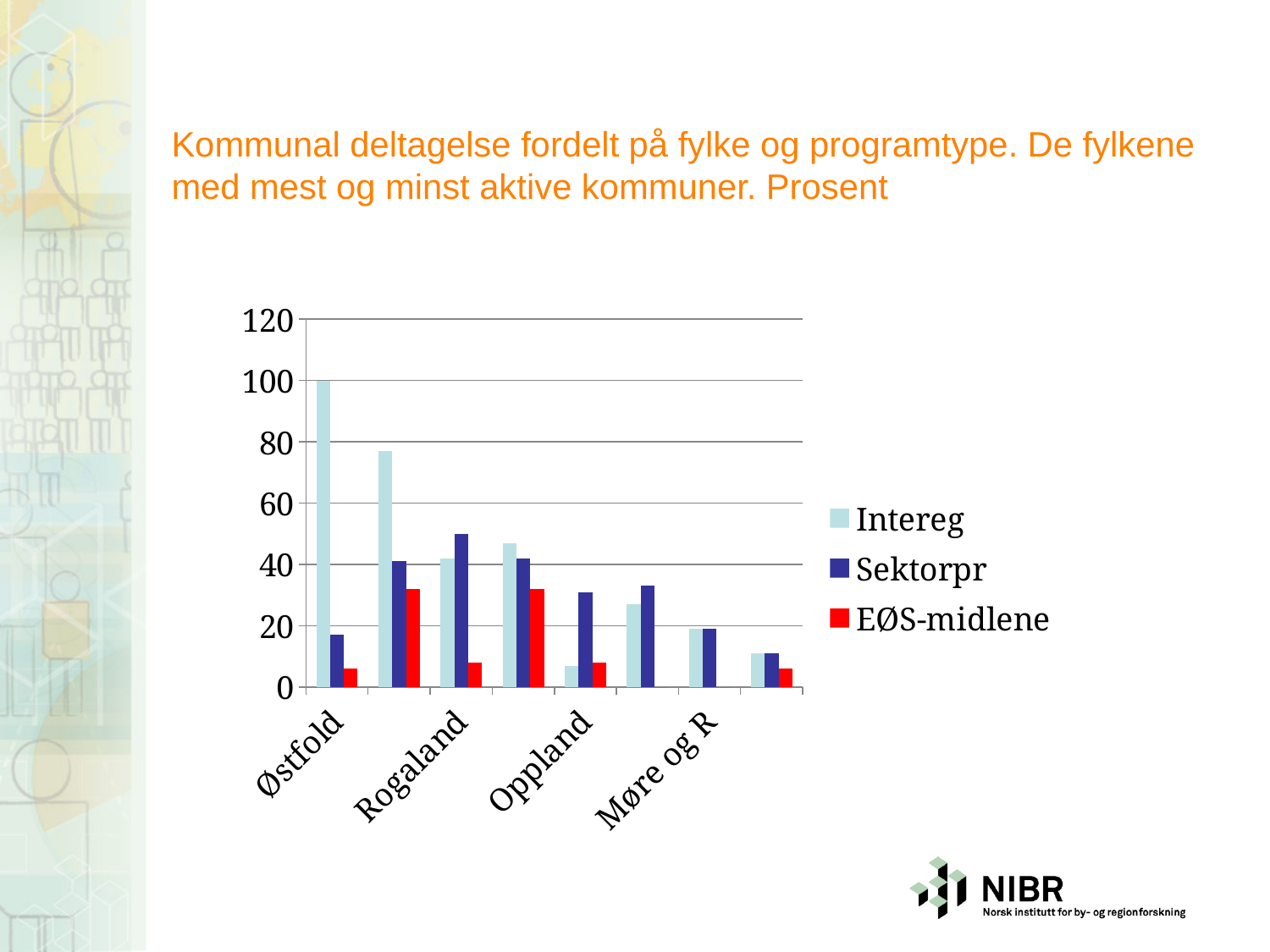
What kind of chart is shown on the slide? bar chart Which is larger, the Intereg value for Østfold or the Intereg value for Rogaland? Østfold Is the Intereg value for Oppland greater or less than 20? less How many series does the legend list? 3 Is the Sektorpr value for Rogaland greater or less than 40? greater Which is larger, the Sektorpr value for Rogaland or the Sektorpr value for Oppland? Rogaland Is the Sektorpr value for Oppland greater or less than 20? greater What are the three series named in the legend? Intereg, Sektorpr, EØS-midlene For Østfold, which series has the highest value? Intereg What is the Intereg value for Østfold? 100